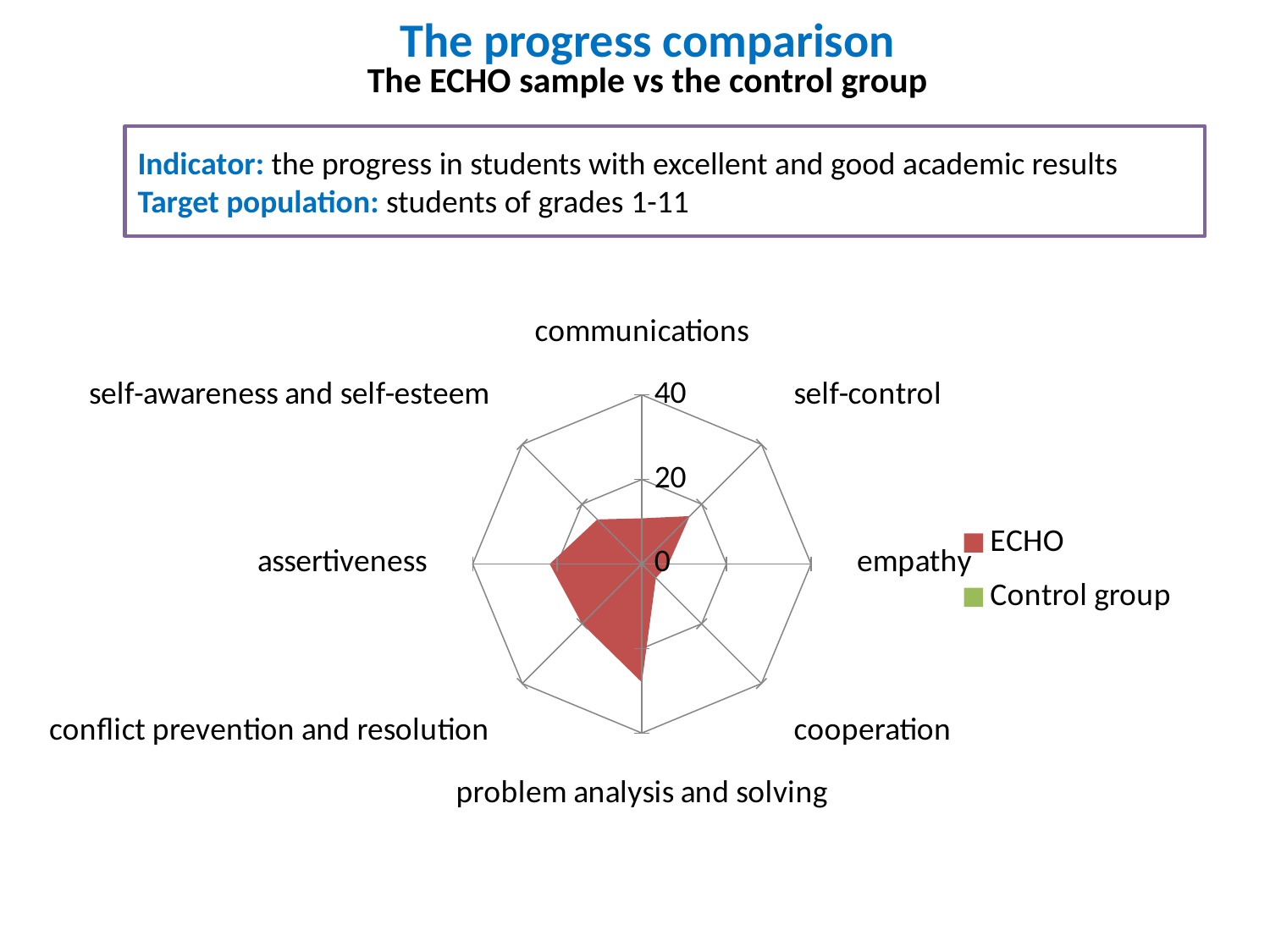
Which series is shown in red in the legend? ECHO How many categories (axes) does the radar chart have? 8 What kind of chart is shown on the slide? radar chart How many series does the legend list? 2 Is the ECHO value for empathy greater or less than 20? less Is the ECHO value for problem analysis and solving greater or less than 20? greater Is the ECHO value for cooperation greater or less than 20? less What is the highest value shown on the chart's axis scale? 40 Which has a larger ECHO value, assertiveness or cooperation? assertiveness Which category has the highest ECHO value? problem analysis and solving Which has a larger ECHO value, problem analysis and solving or empathy? problem analysis and solving